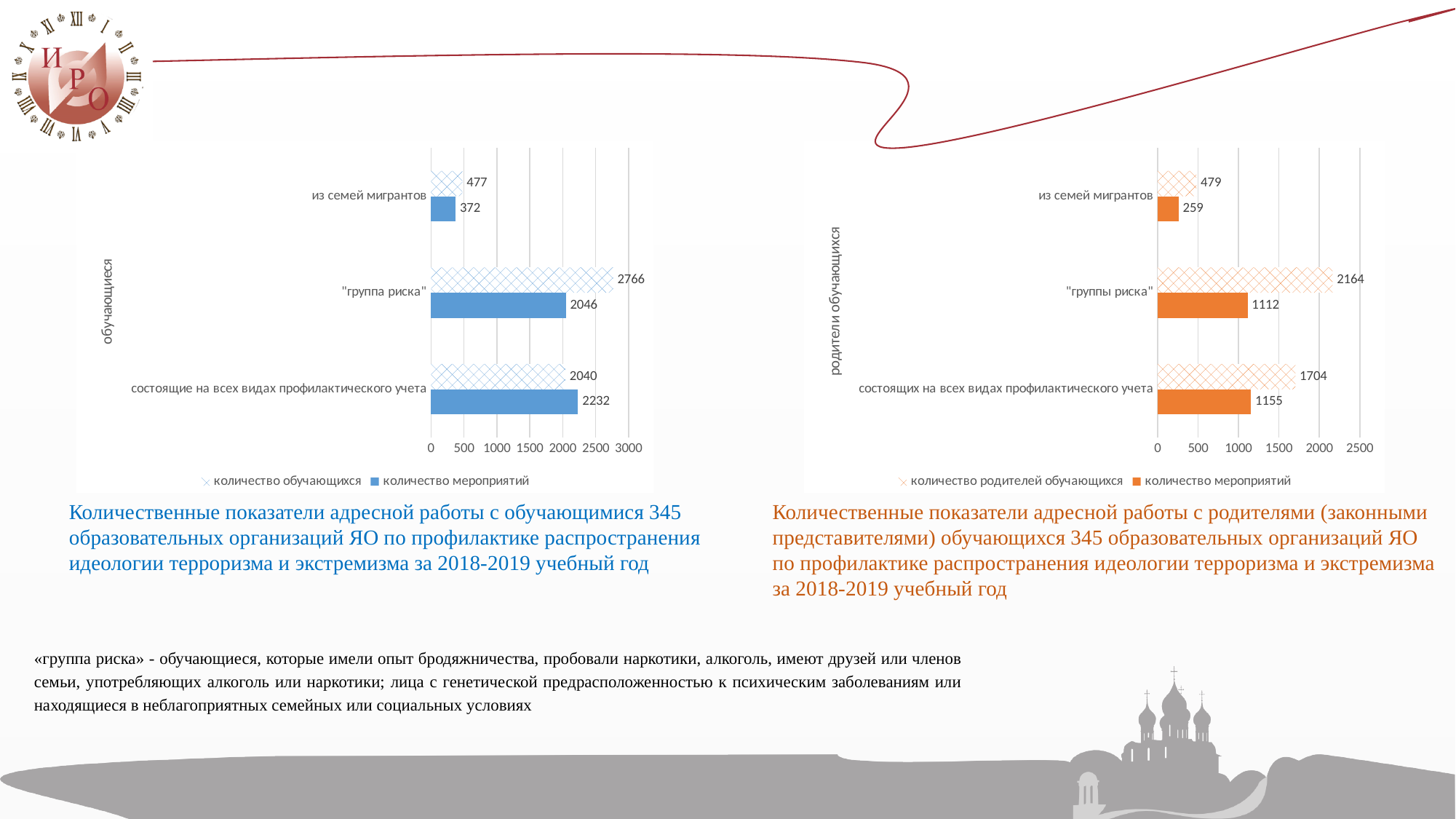
What type of chart is the right chart? bar chart In the left chart, which is larger for состоящие на всех видах профилактического учета: количество обучающихся or количество мероприятий? количество мероприятий In the right chart, what is the value of количество родителей обучающихся for состоящих на всех видах профилактического учета? 1704 In the right chart, what is the difference between количество родителей обучающихся and количество мероприятий for из семей мигрантов? 220 How many categories are shown in the right chart? 3 In the left chart, what is the difference between количество обучающихся and количество мероприятий for "группа риска"? 720 How many series does the legend of the left chart list? 2 In the right chart, what is the value of количество мероприятий for "группы риска"? 1112 In the left chart, what is the value of количество обучающихся for "группа риска"? 2766 In the left chart, which category has the highest value of количество мероприятий? состоящие на всех видах профилактического учета In the left chart, what is the value of количество мероприятий for из семей мигрантов? 372 In the right chart, which category has the lowest value of количество родителей обучающихся? из семей мигрантов